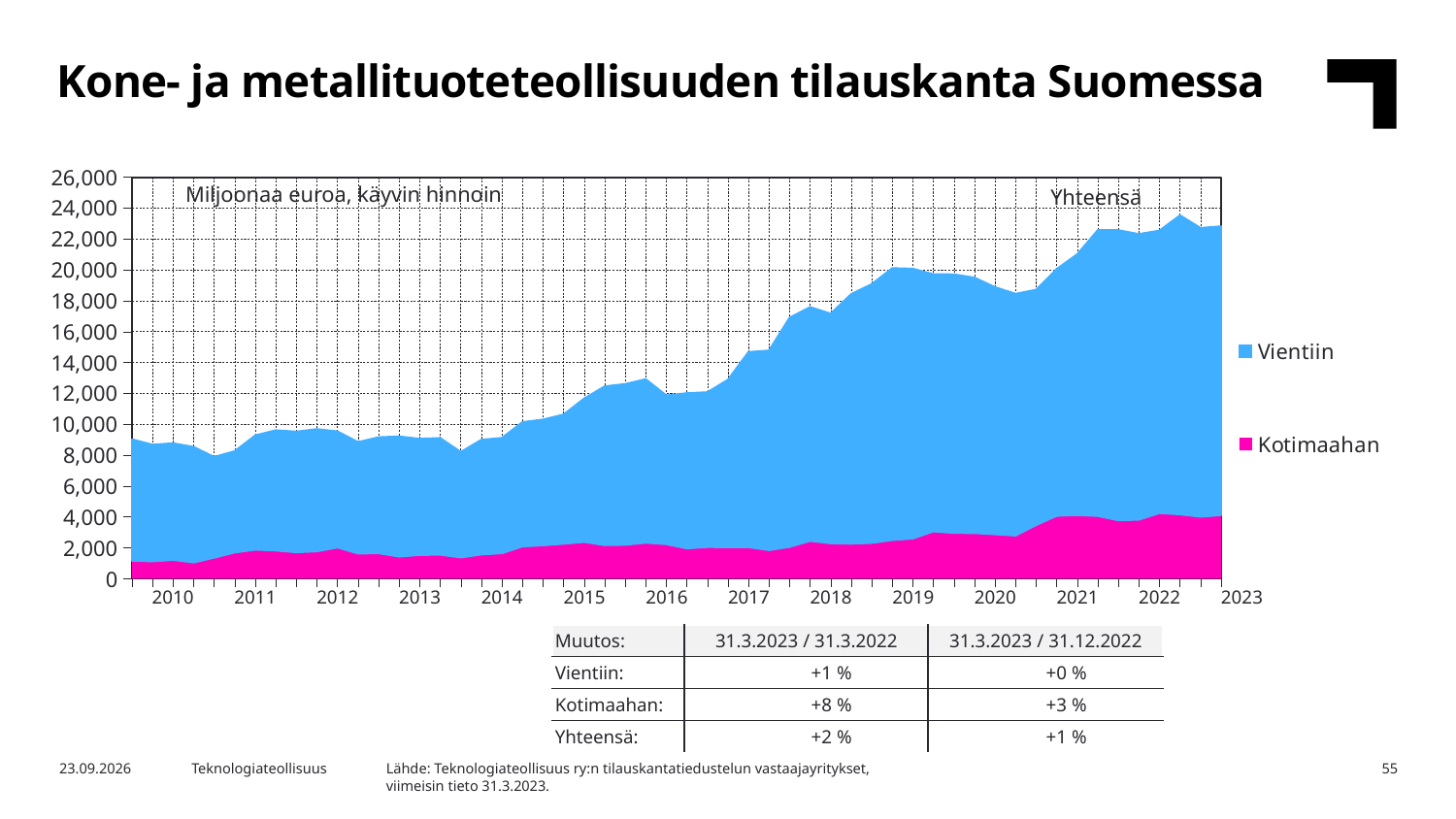
What are the two series named in the chart legend? Vientiin and Kotimaahan Is the Kotimaahan value at the start of 2010 greater or less than 2,000? less Is the Kotimaahan value in 2021 greater or less than 2,000? greater How many series does the chart legend list? 2 How many year labels are shown on the x axis of the chart? 14 Is the total (Yhteensä) value in 2018 greater or less than 14,000? greater What is the title of the chart on the slide? Kone- ja metallituoteteollisuuden tilauskanta Suomessa What kind of chart is shown on the slide? Stacked area chart Does the total order backlog (Yhteensä) generally rise or fall from 2010 to 2023? rise Which series occupies the larger part of the stacked area throughout the chart, Vientiin or Kotimaahan? Vientiin